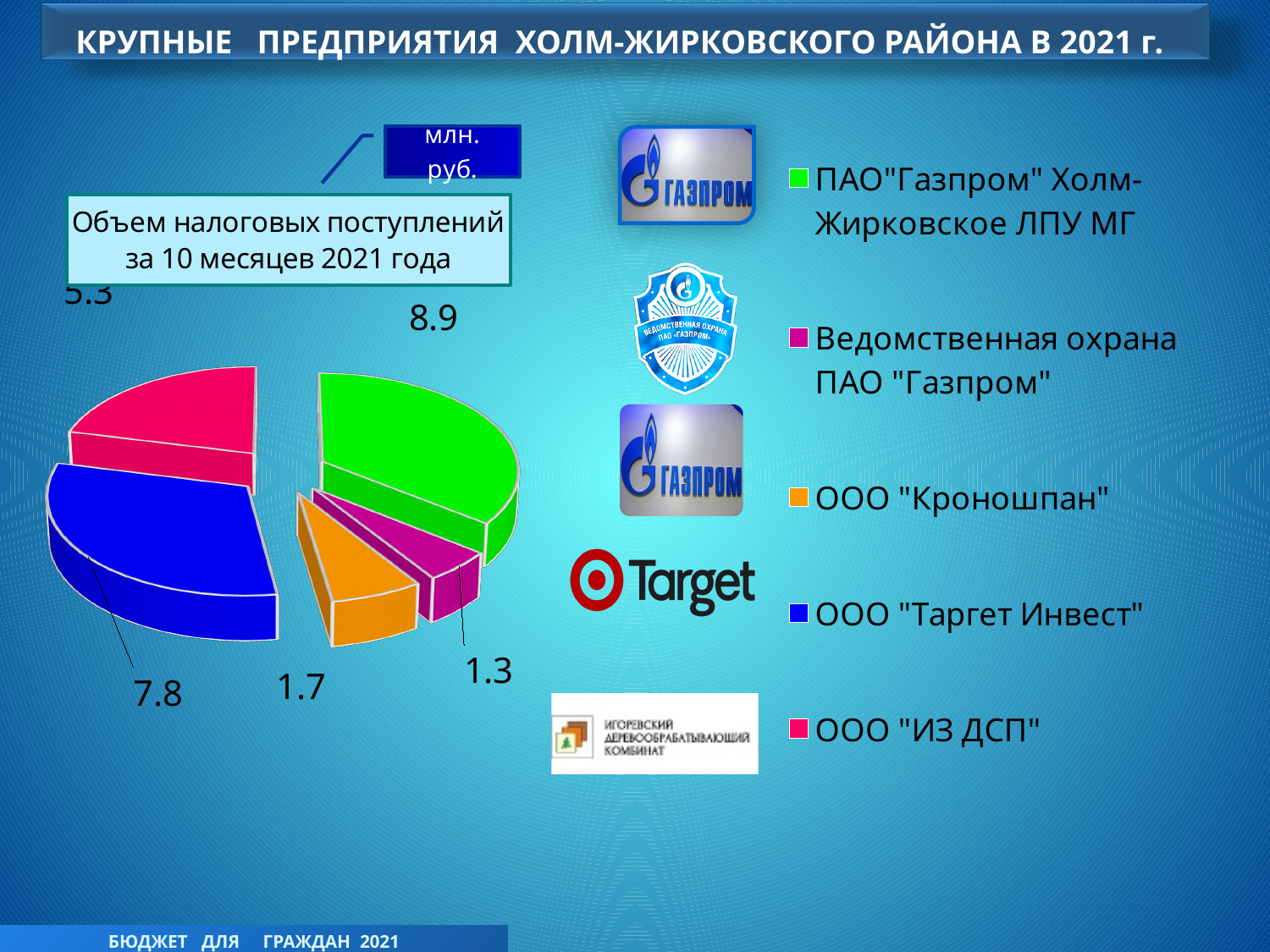
What kind of chart is shown on the slide? Pie chart Which is larger: the value for ООО "Кроношпан" or for Ведомственная охрана ПАО "Газпром"? ООО "Кроношпан" What is the difference between the values for ПАО "Газпром" Холм-Жирковское ЛПУ МГ and ООО "Таргет Инвест"? 1.1 Which enterprise has the highest value in the pie chart? ПАО "Газпром" Холм-Жирковское ЛПУ МГ How many enterprises does the legend of the pie chart list? 5 Which enterprise has the lowest value in the pie chart? Ведомственная охрана ПАО "Газпром" What is the value for Ведомственная охрана ПАО "Газпром" in the pie chart? 1.3 In what units are the values of the pie chart given? млн. руб. What is the difference between the values for ООО "Кроношпан" and Ведомственная охрана ПАО "Газпром"? 0.4 What is the value for ООО "Таргет Инвест" in the pie chart? 7.8 What is the value for ПАО "Газпром" Холм-Жирковское ЛПУ МГ in the pie chart? 8.9 What is the value for ООО "Кроношпан" in the pie chart? 1.7